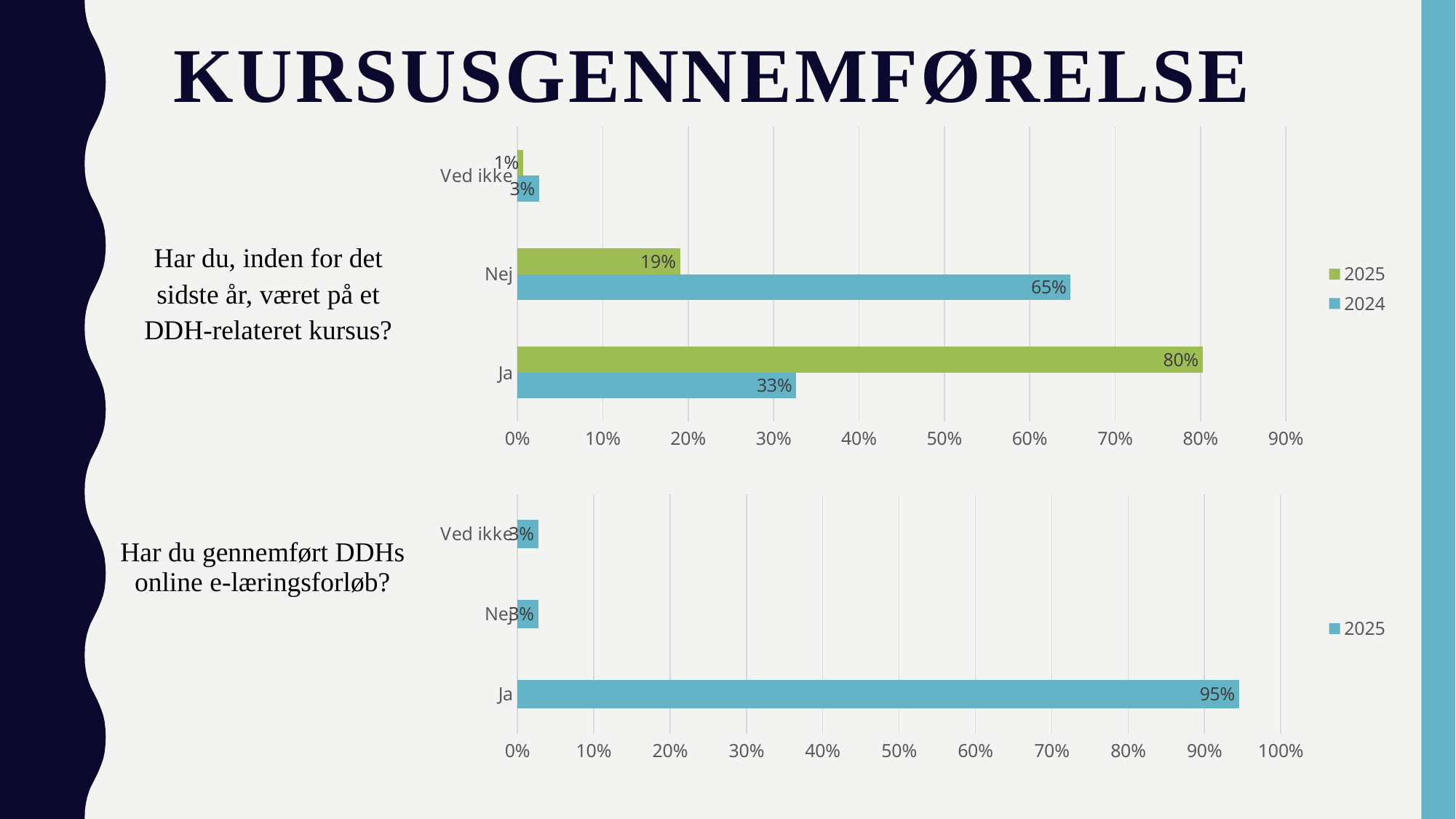
In the bottom chart (Har du gennemført DDHs online e-læringsforløb?), what is the value for Ja? 95% In the bottom chart (Har du gennemført DDHs online e-læringsforløb?), what is the value for Nej? 3% What kind of chart is the bottom chart (Har du gennemført DDHs online e-læringsforløb?)? bar chart How many categories are shown in the bottom chart (Har du gennemført DDHs online e-læringsforløb?)? 3 How many series does the legend of the top chart (Har du, inden for det sidste år, været på et DDH-relateret kursus?) list? 2 In the top chart (Har du, inden for det sidste år, været på et DDH-relateret kursus?), is the 2025 value for Nej larger or smaller than the 2024 value for Nej? smaller In the top chart (Har du, inden for det sidste år, været på et DDH-relateret kursus?), what is the 2024 value for Ja? 33% In the top chart (Har du, inden for det sidste år, været på et DDH-relateret kursus?), what is the difference between the 2025 and 2024 values for Ja? 47% In the top chart (Har du, inden for det sidste år, været på et DDH-relateret kursus?), what is the 2025 value for Ja? 80% In the top chart (Har du, inden for det sidste år, været på et DDH-relateret kursus?), what is the 2024 value for Nej? 65% In the top chart (Har du, inden for det sidste år, været på et DDH-relateret kursus?), which category has the lowest 2025 value? Ved ikke In the top chart (Har du, inden for det sidste år, været på et DDH-relateret kursus?), which category has the highest 2024 value? Nej